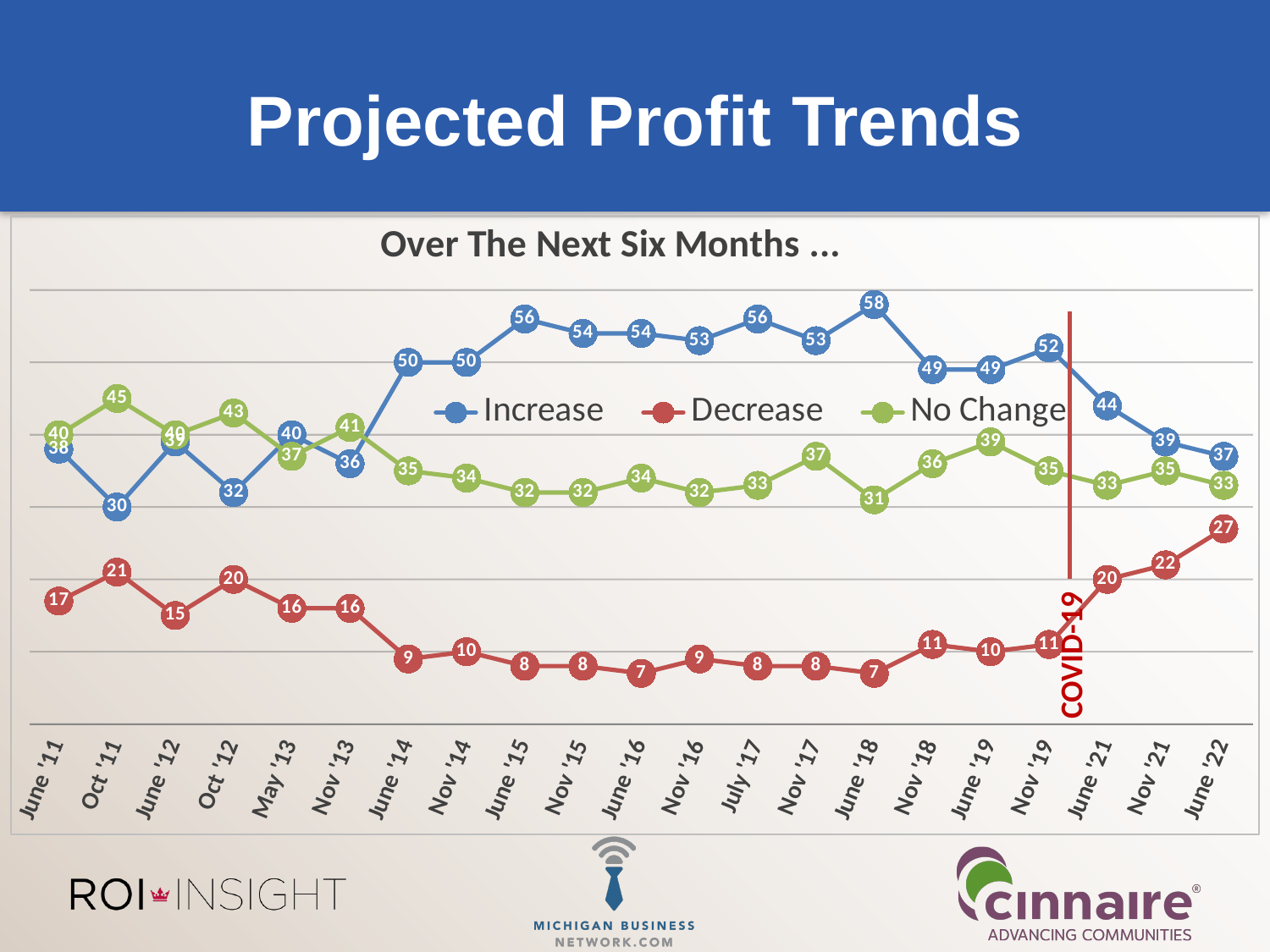
Does the Decrease series rise or fall from Nov '19 to June '22? rise At which date does the Increase series reach its highest value? June '18 What is the value of the Increase series at June '18? 58 At Nov '19, which is larger: the Increase value or the No Change value? Increase How many series does the legend list? 3 At which date does the Decrease series reach its highest value? June '22 At which date is the Increase series at its lowest value? Oct '11 What is the value of the No Change series at Oct '11? 45 What is the difference between the Increase value at June '18 and the Increase value at June '22? 21 What is the value of the Decrease series at June '22? 27 How many dates are shown on the x axis? 21 What kind of chart is shown on the slide? line chart